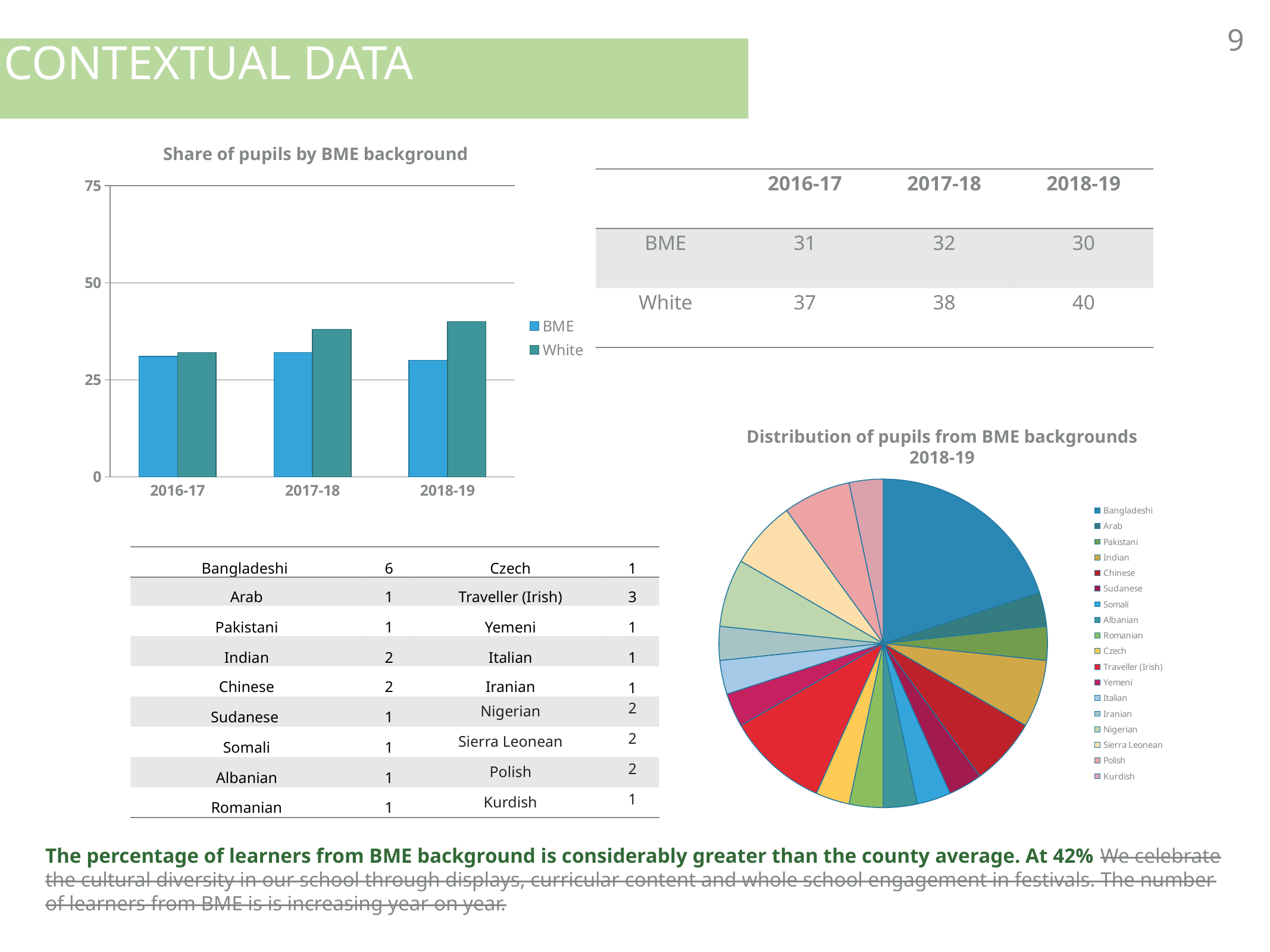
What kind of chart is 'Distribution of pupils from BME backgrounds 2018-19'? pie chart In the 'Share of pupils by BME background' chart, do the White values rise or fall from 2016-17 to 2018-19? rise In the 'Share of pupils by BME background' chart, how many series does the legend list? 2 In the 'Distribution of pupils from BME backgrounds 2018-19' pie chart, which is larger, the Traveller (Irish) slice or the Czech slice? Traveller (Irish) In the 'Share of pupils by BME background' chart, how many year categories are shown on the x axis? 3 In the 'Share of pupils by BME background' chart, is the White value for 2018-19 greater or less than 25? greater According to the table next to the 'Share of pupils by BME background' chart, what is the White value for 2018-19? 40 In the 'Distribution of pupils from BME backgrounds 2018-19' pie chart, how many entries does the legend list? 18 In the 'Share of pupils by BME background' chart, which is larger in 2018-19, BME or White? White What kind of chart is 'Share of pupils by BME background'? bar chart In the 'Distribution of pupils from BME backgrounds 2018-19' pie chart, which group has the largest slice? Bangladeshi In the 'Share of pupils by BME background' chart, is the BME value for 2016-17 greater or less than 50? less